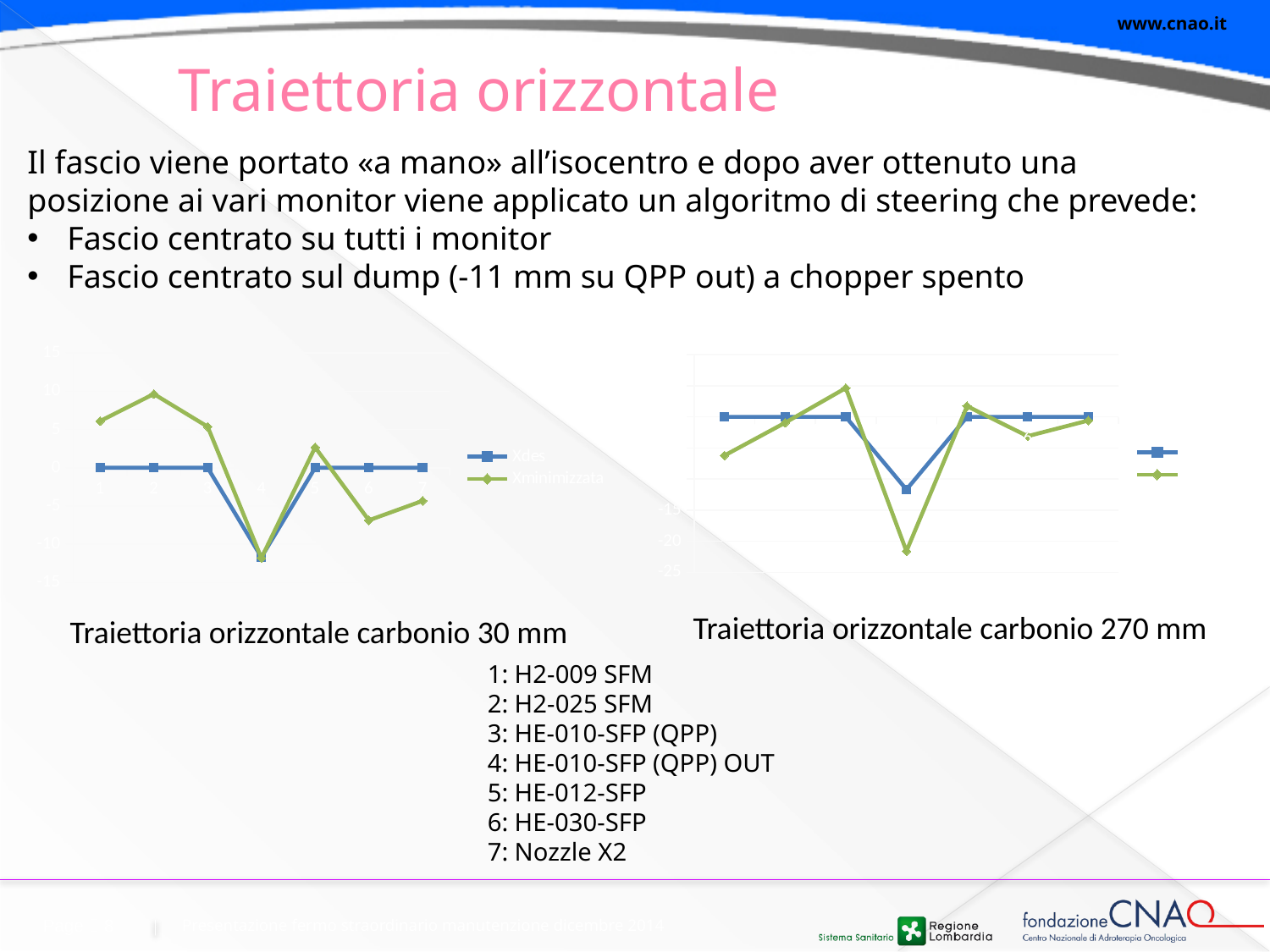
In the 'Traiettoria orizzontale carbonio 30 mm' chart, at which point is the Xminimizzata value highest? 2 What kind of chart is the 'Traiettoria orizzontale carbonio 30 mm' chart on the left? line chart In the 'Traiettoria orizzontale carbonio 30 mm' chart, is the Xdes value at point 4 greater or less than -5? less How many series does the legend of the 'Traiettoria orizzontale carbonio 30 mm' chart list? 2 In the 'Traiettoria orizzontale carbonio 30 mm' chart, is the Xminimizzata value at point 2 greater or less than 5? greater In the 'Traiettoria orizzontale carbonio 30 mm' chart, is the Xminimizzata value at point 6 greater or less than -5? less In the 'Traiettoria orizzontale carbonio 270 mm' chart on the right, at which point does the green series reach its lowest value? 4 How many points are plotted along the x axis of the 'Traiettoria orizzontale carbonio 30 mm' chart? 7 In the 'Traiettoria orizzontale carbonio 30 mm' chart, which series has the larger value at point 2, Xdes or Xminimizzata? Xminimizzata What are the two legend entries of the 'Traiettoria orizzontale carbonio 30 mm' chart? Xdes and Xminimizzata In the 'Traiettoria orizzontale carbonio 30 mm' chart, at which point is the Xminimizzata value lowest? 4